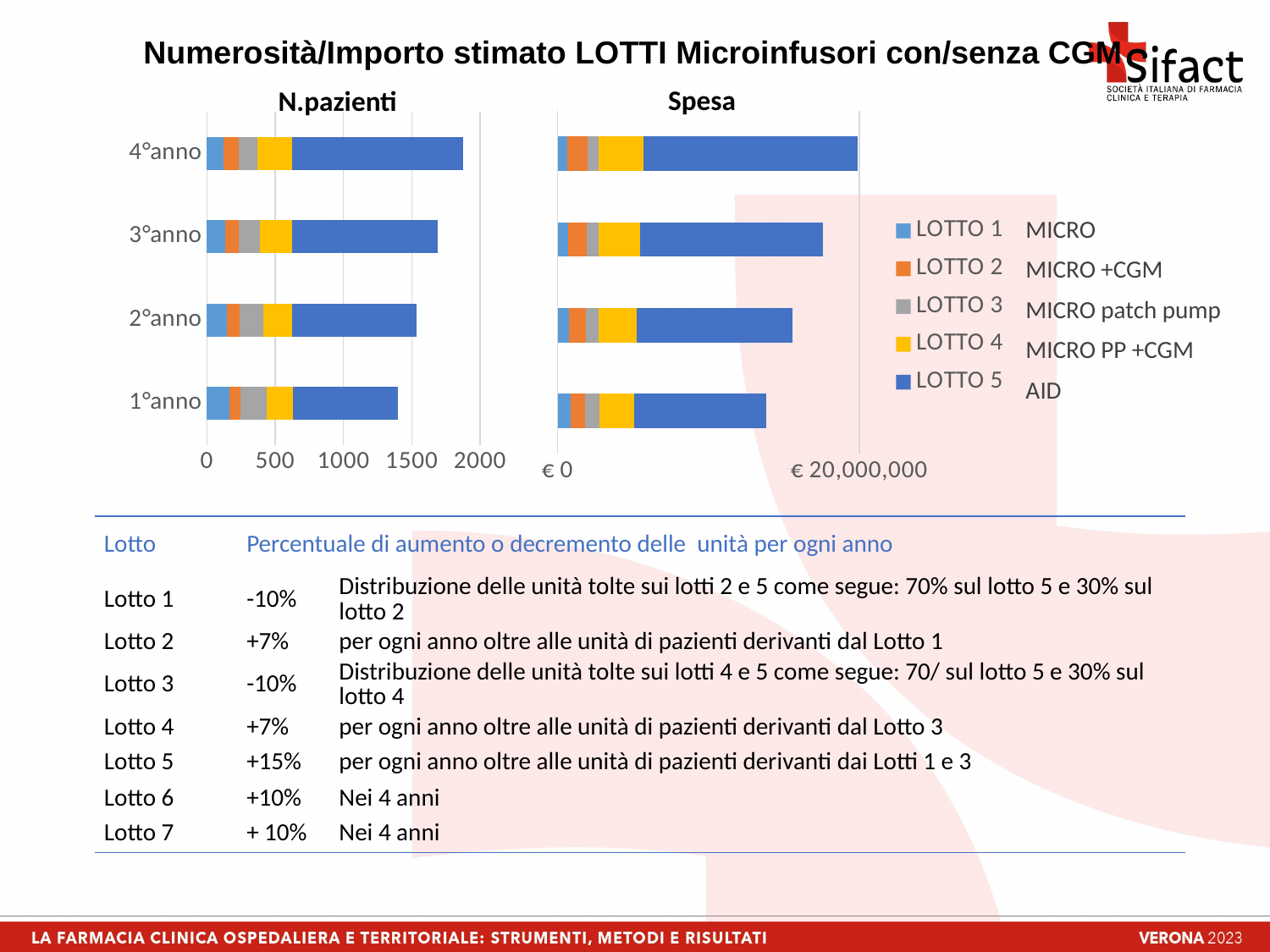
In the "Spesa" chart, which year has the lowest total spending? 1°anno In the "N.pazienti" chart, which year has the longest total bar? 4°anno In the "N.pazienti" chart, is the total value for 4°anno greater or less than 1500? greater Which LOTTO in the legend corresponds to AID? LOTTO 5 In the "N.pazienti" chart, which year has the shortest total bar? 1°anno In the "Spesa" chart, do the total bars rise or fall from 1°anno to 4°anno? rise In the "Spesa" chart, which year has the highest total spending? 4°anno What kind of chart is the "N.pazienti" chart? Stacked bar chart How many year categories are shown in the "Spesa" chart? 4 How many series (LOTTO entries) does the legend list? 5 In the "N.pazienti" chart, is the total value for 1°anno greater or less than 1500? less In the "N.pazienti" chart, is the total for 3°anno larger or smaller than the total for 2°anno? larger